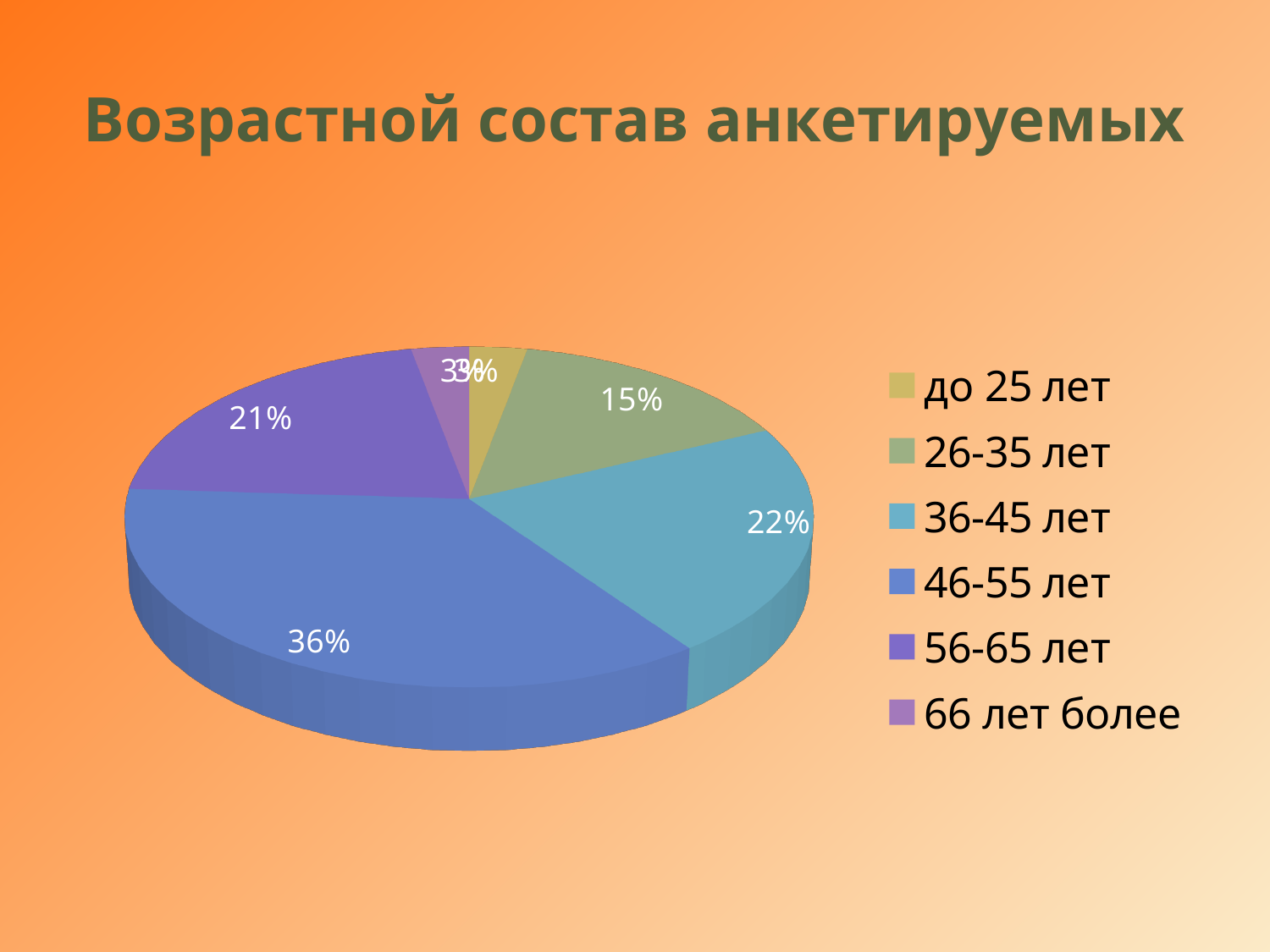
What share of respondents are in the 46-55 лет group? 36% What share of respondents are in the 56-65 лет group? 21% What share of respondents are in the 26-35 лет group? 15% What colour is the slice for the 46-55 лет group? blue What is the difference in percentage points between the 46-55 лет and 36-45 лет groups? 14 What is the difference in percentage points between the 36-45 лет and 56-65 лет groups? 1 What is the title of the chart? Возрастной состав анкетируемых What kind of chart is shown on the slide? pie chart Which age group has the largest share of respondents? 46-55 лет How many age groups does the legend list? 6 What share of respondents are in the 36-45 лет group? 22% Which group has a larger share: 26-35 лет or 56-65 лет? 56-65 лет